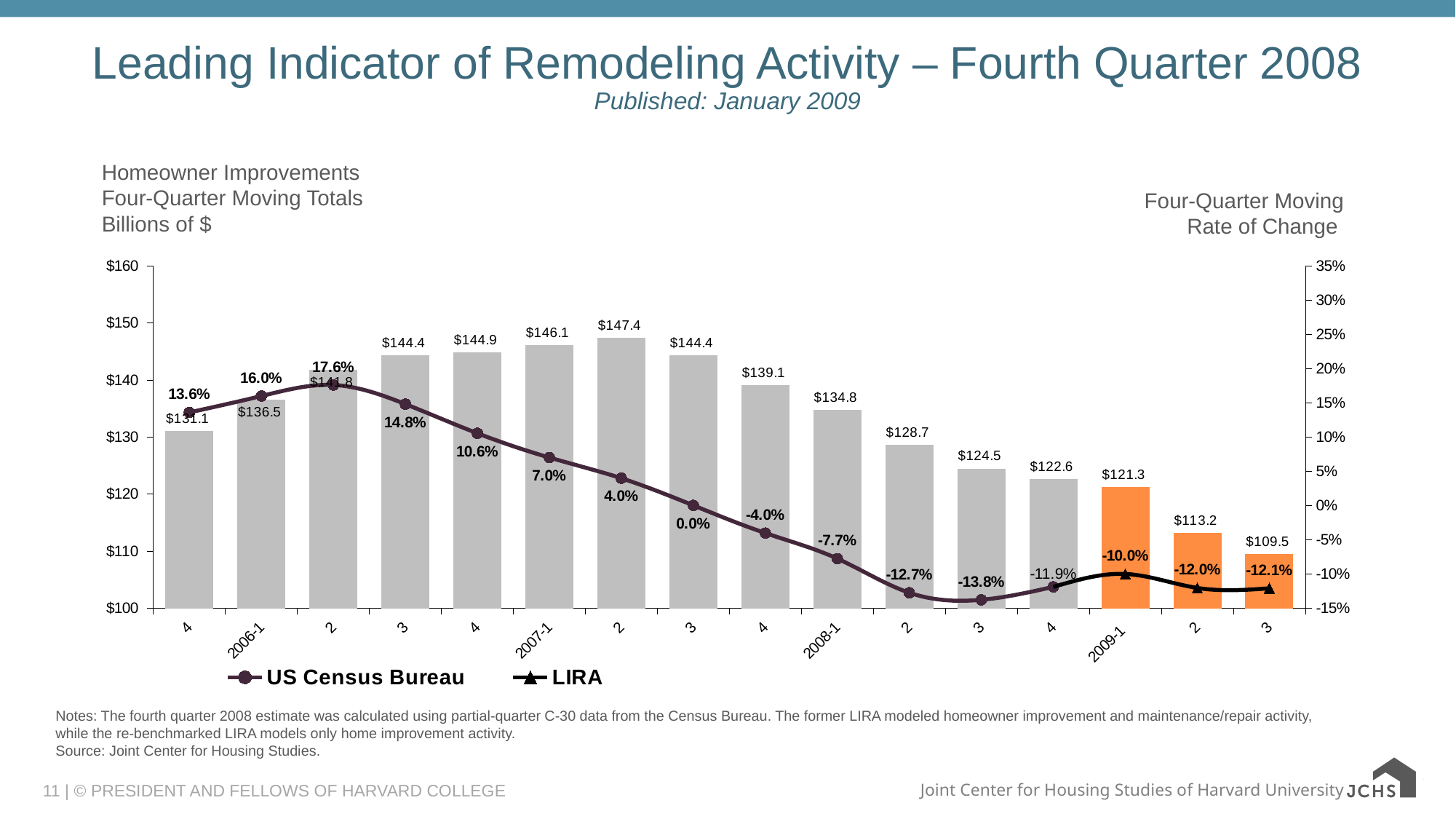
Which is larger, the homeowner improvements bar for 2008-4 or for 2009-1? 2008-4 Which quarter has the highest homeowner improvements bar? 2007-2 What is the four-quarter moving rate of change shown for 2009-1? -10.0% Does the four-quarter moving rate of change rise or fall from 2006-2 to 2008-3? fall Is the homeowner improvements value for 2008-2 greater or less than $130? less How many series does the legend list? 2 What is the lowest homeowner improvements value shown on the chart? $109.5 What is the four-quarter moving total of homeowner improvements for the second quarter of 2007 (the bar labelled 2 after 2007-1)? $147.4 What is the highest four-quarter moving rate of change shown on the line? 17.6% How many quarterly bars are plotted on the chart? 16 What kind of chart is shown on the slide? Combined bar and line chart What is the difference between the homeowner improvements bars for 2008-1 and 2009-1? $13.5